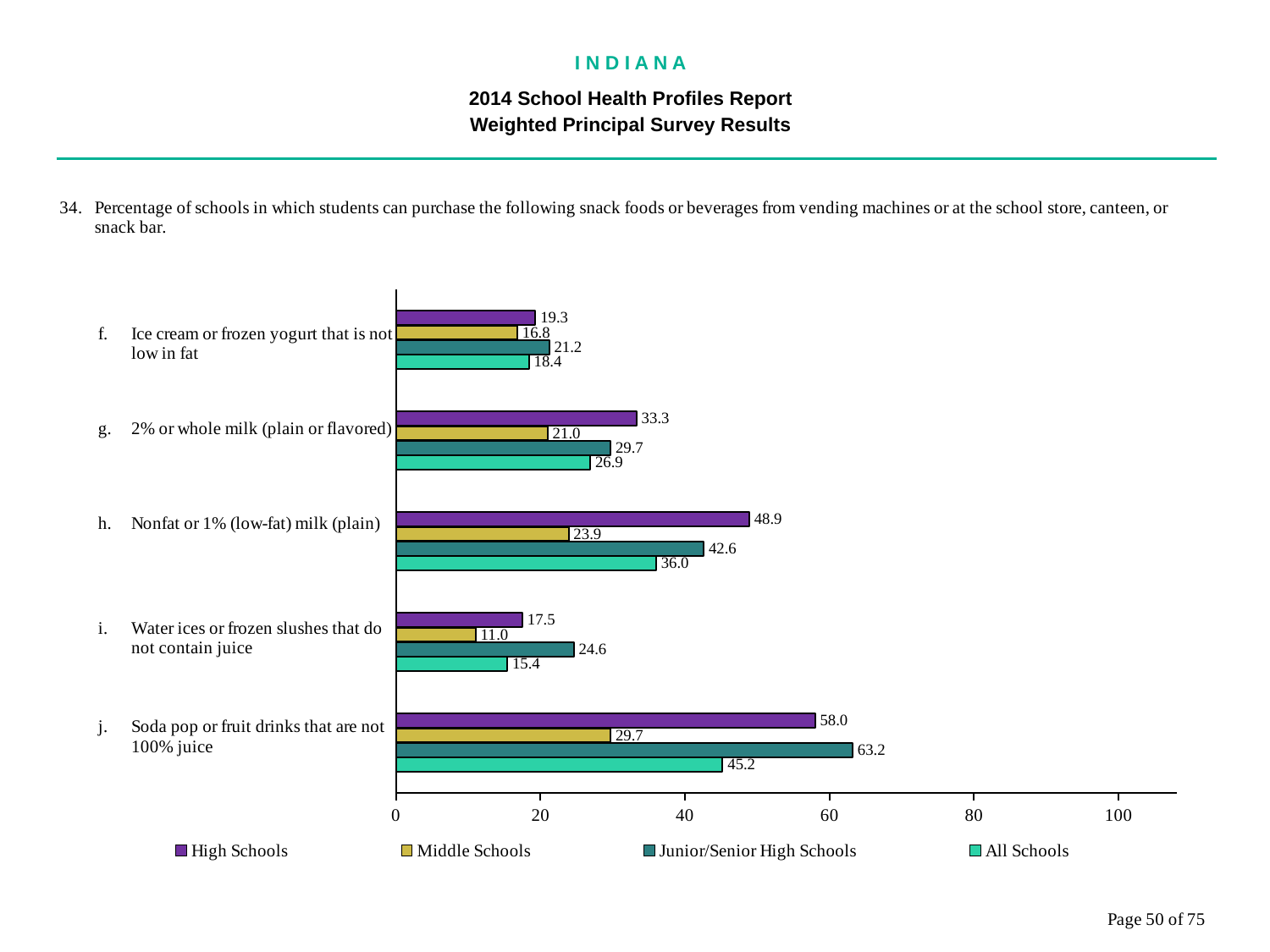
What is the value for All Schools for '2% or whole milk (plain or flavored)'? 26.9 For 'Soda pop or fruit drinks that are not 100% juice', which is larger: High Schools or Junior/Senior High Schools? Junior/Senior High Schools What is the difference between the High Schools and Middle Schools values for 'Nonfat or 1% (low-fat) milk (plain)'? 25.0 What is the value for Middle Schools for 'Nonfat or 1% (low-fat) milk (plain)'? 23.9 Which category has the highest value for Junior/Senior High Schools? Soda pop or fruit drinks that are not 100% juice Which category has the lowest value for Middle Schools? Water ices or frozen slushes that do not contain juice How many snack food or beverage categories are shown in the chart? 5 What is the value for High Schools for 'Soda pop or fruit drinks that are not 100% juice'? 58.0 What kind of chart is shown on the slide? bar chart Is the value for All Schools for 'Soda pop or fruit drinks that are not 100% juice' greater or less than 40? greater How many series does the legend list? 4 Which series is shown in purple in the legend? High Schools